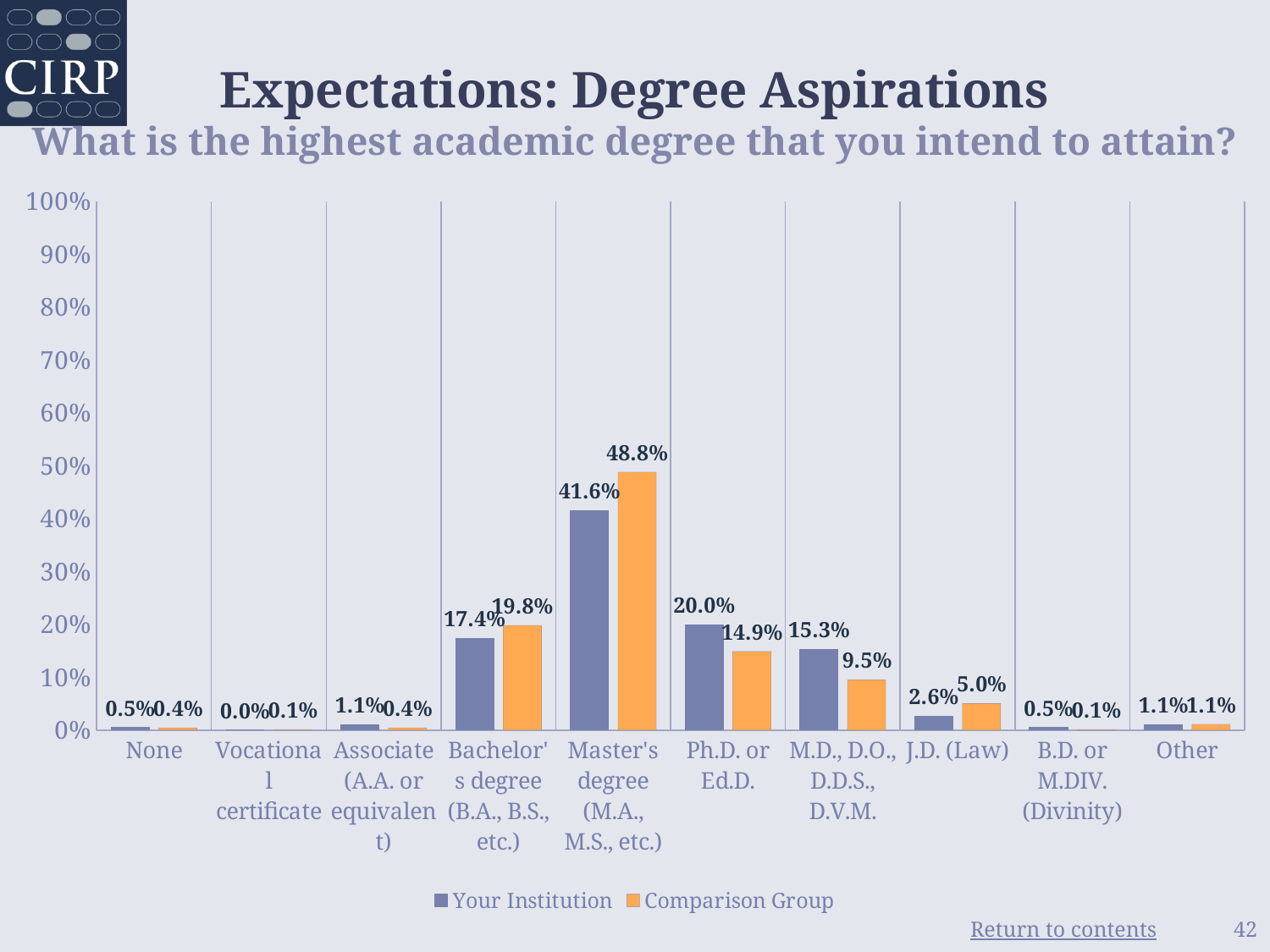
Which is larger for M.D., D.O., D.D.S., D.V.M.: Your Institution or Comparison Group? Your Institution What is the difference between Comparison Group and Your Institution for Master's degree (M.A., M.S., etc.)? 7.2% What is the value for Comparison Group for Ph.D. or Ed.D.? 14.9% Which category has the lowest value for Your Institution? Vocational certificate Is the value for Your Institution for Bachelor's degree (B.A., B.S., etc.) greater or less than 20%? less How many series does the legend list? 2 How many categories are shown on the x axis? 10 What is the difference between Your Institution and Comparison Group for Ph.D. or Ed.D.? 5.1% What is the value for Your Institution for J.D. (Law)? 2.6% What is the value for Your Institution for Master's degree (M.A., M.S., etc.)? 41.6% Which category has the highest value for Comparison Group? Master's degree (M.A., M.S., etc.) What kind of chart is shown on the slide? bar chart